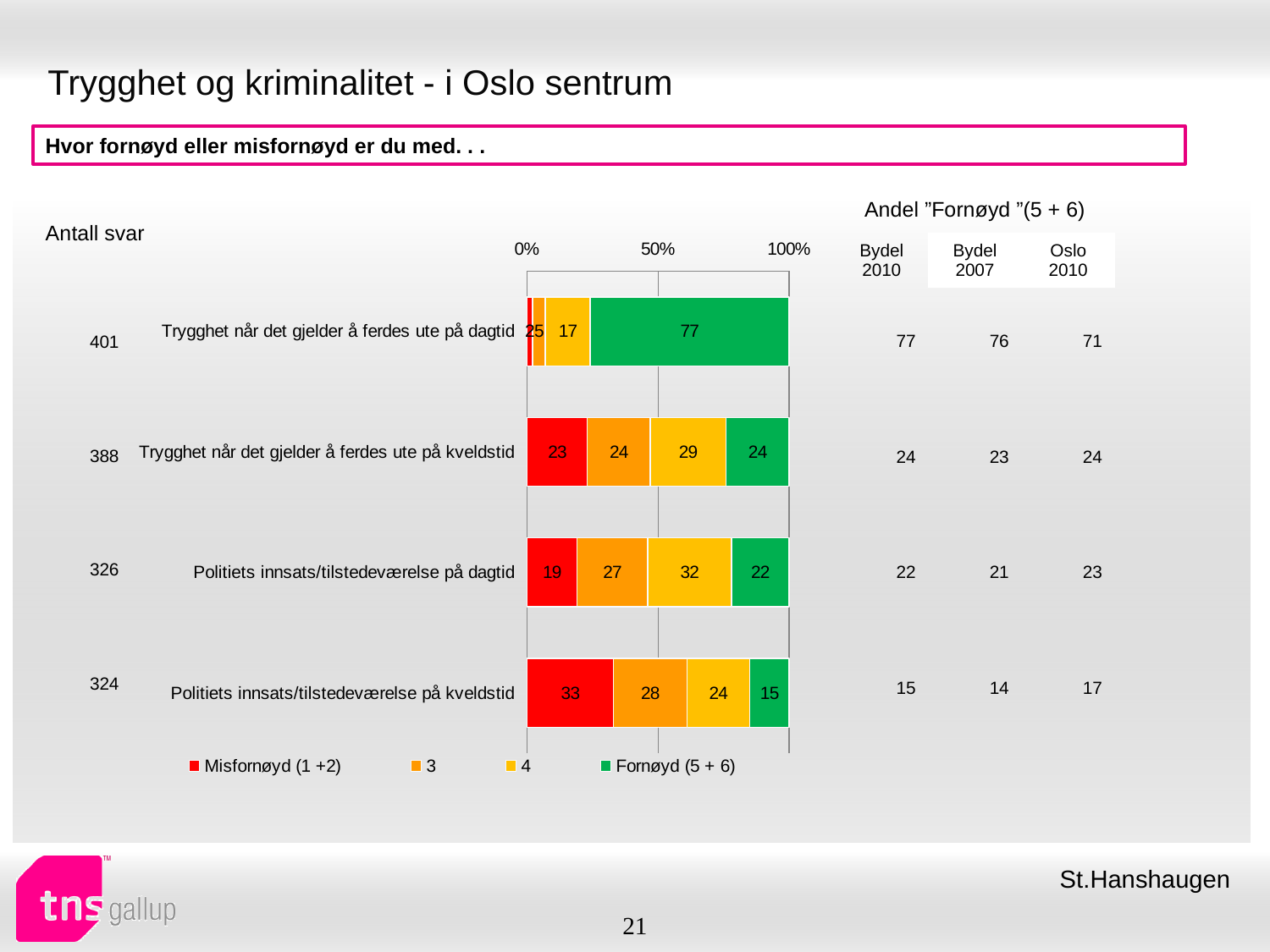
How many categories (bars) does the chart show? 4 What is the value of series '3' for 'Trygghet når det gjelder å ferdes ute på kveldstid'? 24 What kind of chart is shown on the slide? stacked bar chart What is the 'Misfornøyd (1 +2)' value for 'Politiets innsats/tilstedeværelse på kveldstid'? 33 Which category has the highest 'Fornøyd (5 + 6)' value? Trygghet når det gjelder å ferdes ute på dagtid Which category has the lowest 'Fornøyd (5 + 6)' value? Politiets innsats/tilstedeværelse på kveldstid What is the 'Fornøyd (5 + 6)' value for 'Trygghet når det gjelder å ferdes ute på dagtid'? 77 What is the difference between the 'Misfornøyd (1 +2)' values for 'Politiets innsats/tilstedeværelse på kveldstid' and 'Politiets innsats/tilstedeværelse på dagtid'? 14 How many series does the legend list? 4 What is the value of series '4' for 'Politiets innsats/tilstedeværelse på dagtid'? 32 Which is larger: the 'Fornøyd (5 + 6)' value for 'Trygghet når det gjelder å ferdes ute på kveldstid' or for 'Politiets innsats/tilstedeværelse på dagtid'? Trygghet når det gjelder å ferdes ute på kveldstid Which legend entry is shown in green? Fornøyd (5 + 6)